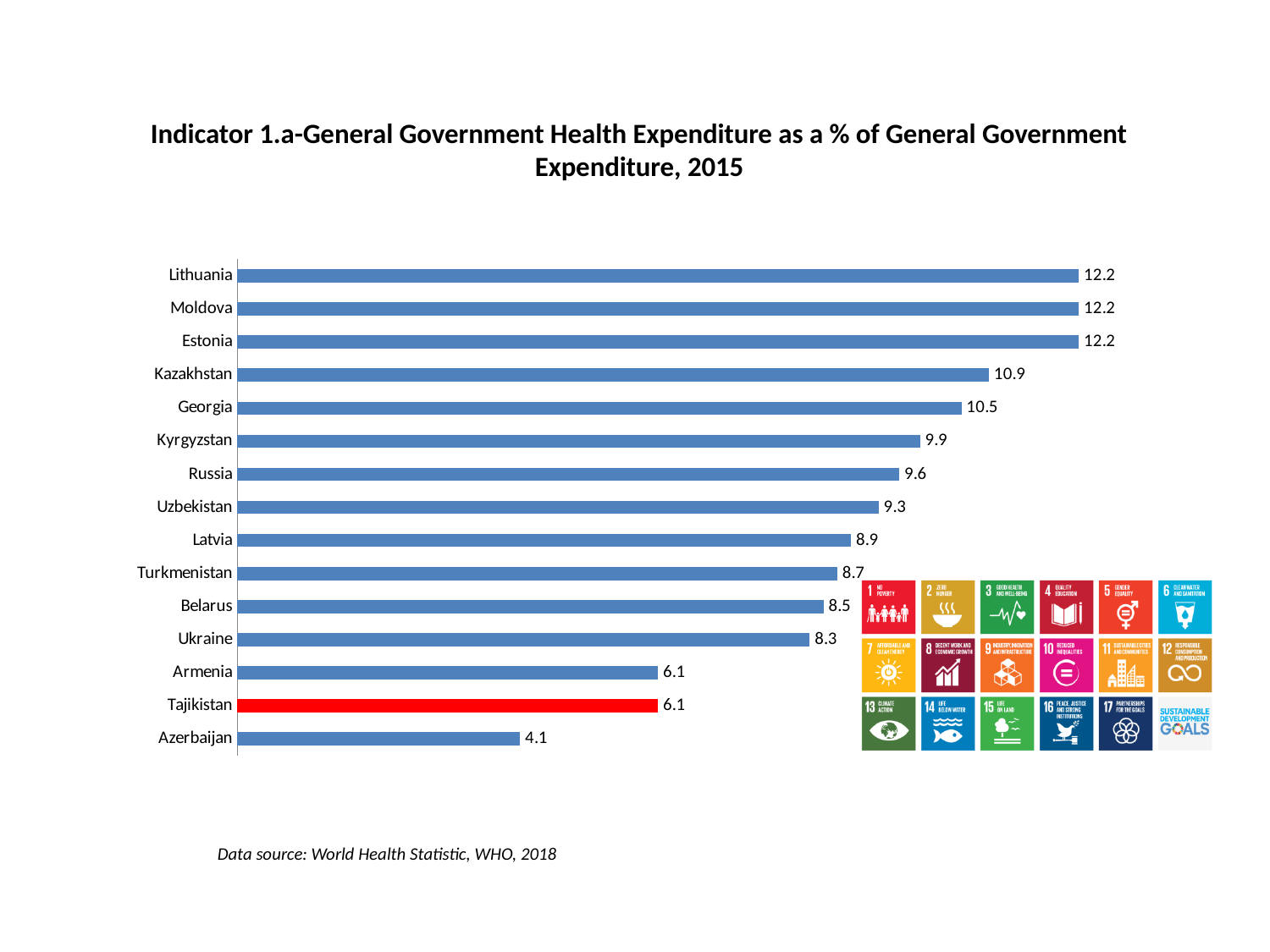
What is the value for Tajikistan? 6.1 What is the difference between the values for Lithuania and Azerbaijan? 8.1 Which country has the lowest value? Azerbaijan Which country's bar is coloured red? Tajikistan How many countries are shown on the chart? 15 Which has a larger value, Kyrgyzstan or Russia? Kyrgyzstan What is the highest value shown on the chart? 12.2 What is the value for Kazakhstan? 10.9 Which has a larger value, Belarus or Ukraine? Belarus What is the value for Uzbekistan? 9.3 What is the difference between the values for Kazakhstan and Georgia? 0.4 What kind of chart is shown on the slide? Bar chart